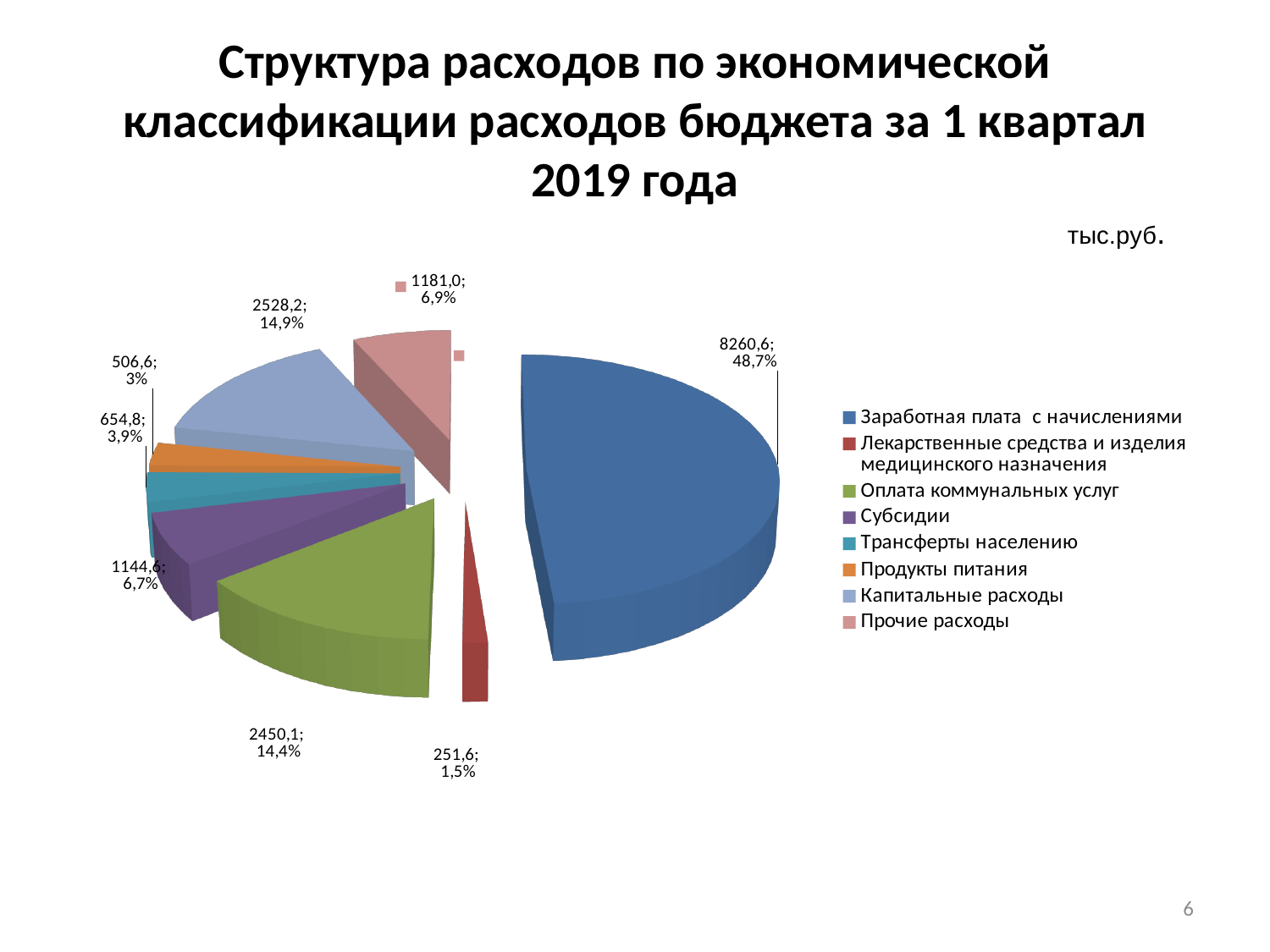
What is the value for Оплата коммунальных услуг? 2450,1 What is the difference between the values for Заработная плата с начислениями and Оплата коммунальных услуг? 5810,5 What share of the pie does Заработная плата с начислениями take? 48,7% Which category has the smallest share of expenses? Лекарственные средства и изделия медицинского назначения Which is larger, Капитальные расходы or Оплата коммунальных услуг? Капитальные расходы How many entries does the legend list? 8 What is the value for Заработная плата с начислениями? 8260,6 How many categories does the pie chart show? 8 Which category has the largest share of expenses? Заработная плата с начислениями What is the value for Лекарственные средства и изделия медицинского назначения? 251,6 What kind of chart is shown on the slide? pie chart What share of the pie does Капитальные расходы take? 14,9%